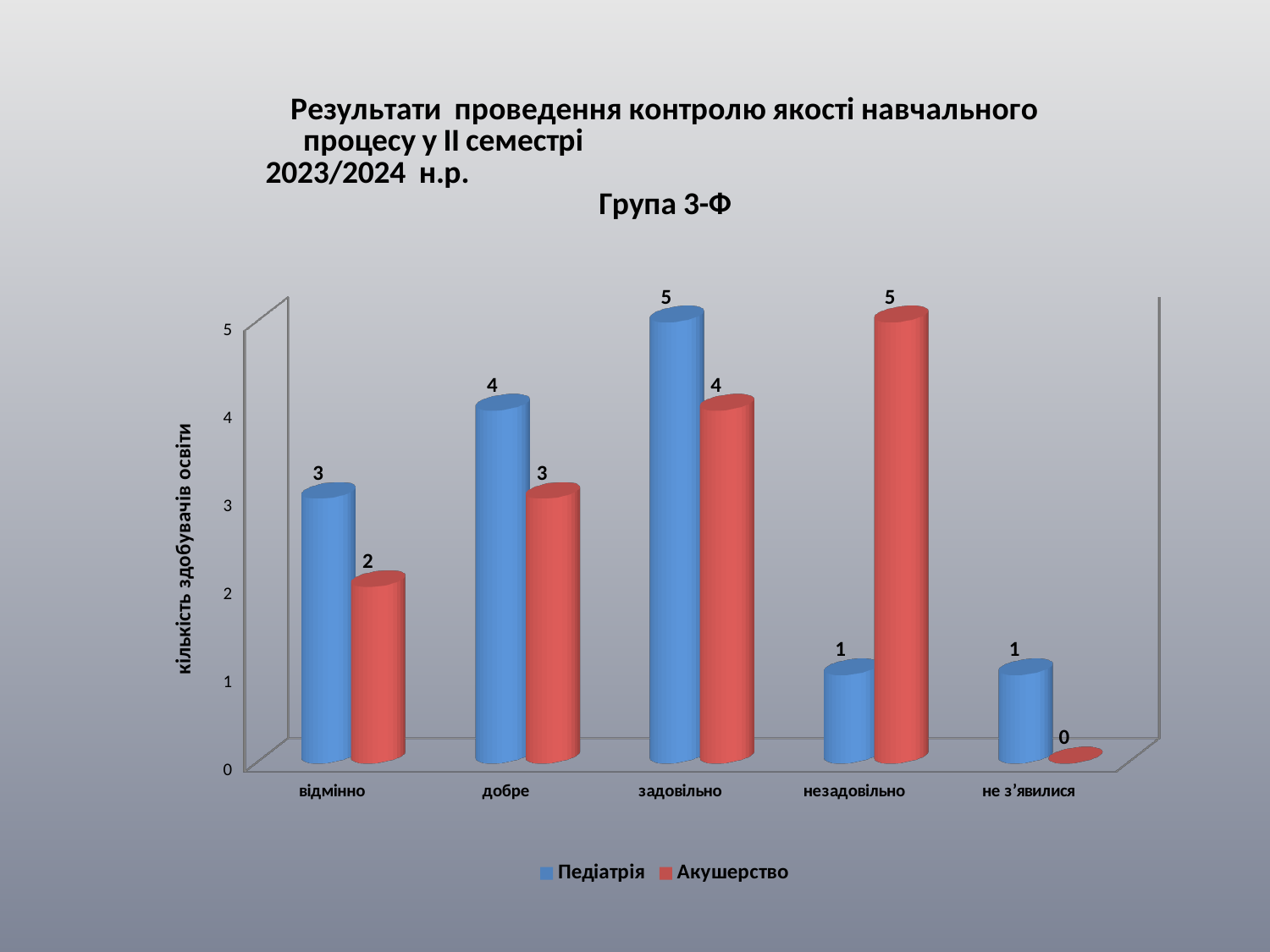
What is the total of Педіатрія and Акушерство in the задовільно category? 9 Which is larger in the добре category, Педіатрія or Акушерство? Педіатрія What is the label of the vertical axis? кількість здобувачів освіти How many categories are shown on the x axis? 5 Which category has the lowest value for Акушерство? не з’явилися What is the value for Акушерство in the незадовільно category? 5 What is the value for Педіатрія in the відмінно category? 3 Which category has the highest value for Педіатрія? задовільно What is the value for Акушерство in the не з’явилися category? 0 What is the difference between Педіатрія and Акушерство in the незадовільно category? 4 What kind of chart is shown on the slide? bar chart How many series does the legend list? 2